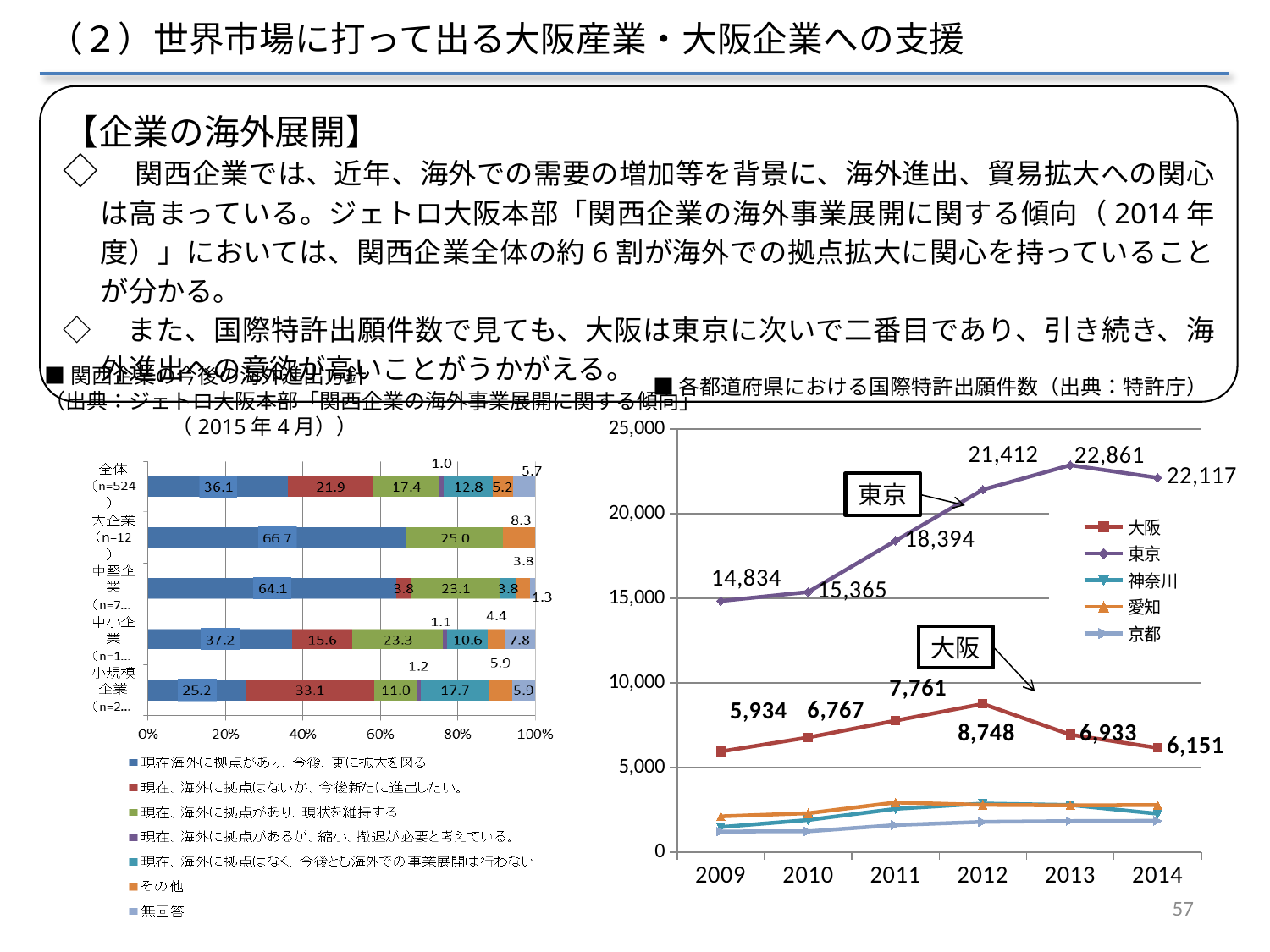
In the right chart (各都道府県における国際特許出願件数), what is the value for 東京 in 2013? 22,861 In the left chart (関西企業の今後の海外進出方針), what is the value of the first (blue) segment for 大企業? 66.7 In the right chart (各都道府県における国際特許出願件数), in which year is the 大阪 value highest? 2012 What kind of chart is the left chart (関西企業の今後の海外進出方針)? Stacked bar chart In the right chart (各都道府県における国際特許出願件数), what is the value for 大阪 in 2012? 8,748 In the right chart (各都道府県における国際特許出願件数), which is larger: the 大阪 value in 2010 or in 2013? 2013 In the right chart (各都道府県における国際特許出願件数), what is the value for 東京 in 2009? 14,834 In the right chart (各都道府県における国際特許出願件数), how many years are shown on the x axis? 6 In the right chart (各都道府県における国際特許出願件数), how many series does the legend list? 5 In the right chart (各都道府県における国際特許出願件数), is the value for 神奈川 in 2012 greater or less than 5,000? less In the right chart (各都道府県における国際特許出願件数), in which year is the 東京 value lowest? 2009 In the right chart (各都道府県における国際特許出願件数), what is the difference between the 東京 value and the 大阪 value in 2014? 15,966